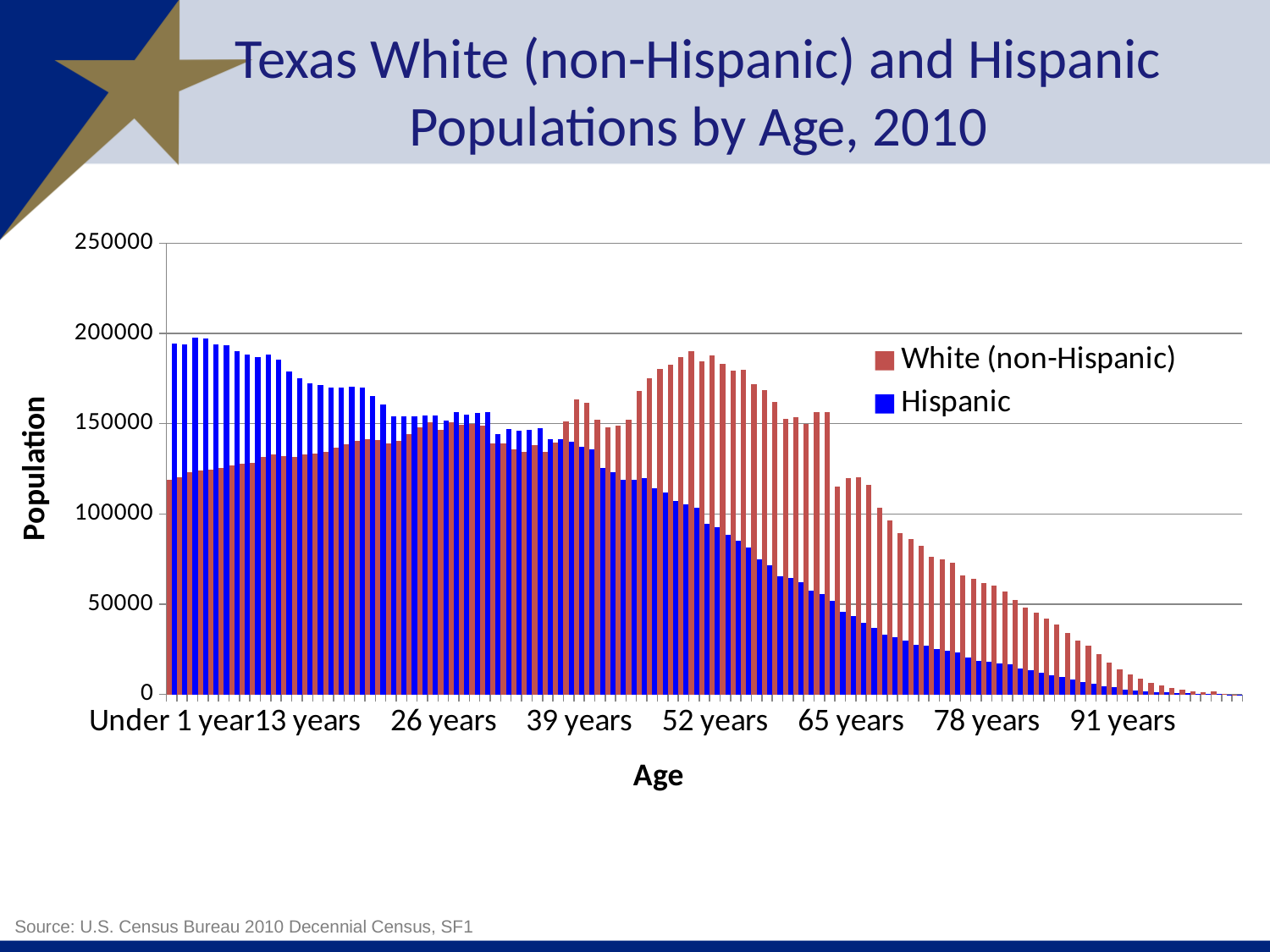
What is the title of the vertical axis? Population At 52 years, which series has the larger value, White (non-Hispanic) or Hispanic? White (non-Hispanic) What kind of chart is shown on the slide? Bar chart Is the White (non-Hispanic) value for Under 1 year greater or less than 150000? less At Under 1 year, which series has the larger value, White (non-Hispanic) or Hispanic? Hispanic Is the Hispanic value for 78 years greater or less than 50000? less Which series is shown in blue? Hispanic How many series does the legend list? 2 Is the Hispanic value for Under 1 year greater or less than 150000? greater Do the Hispanic values generally rise or fall as age increases along the x axis? fall